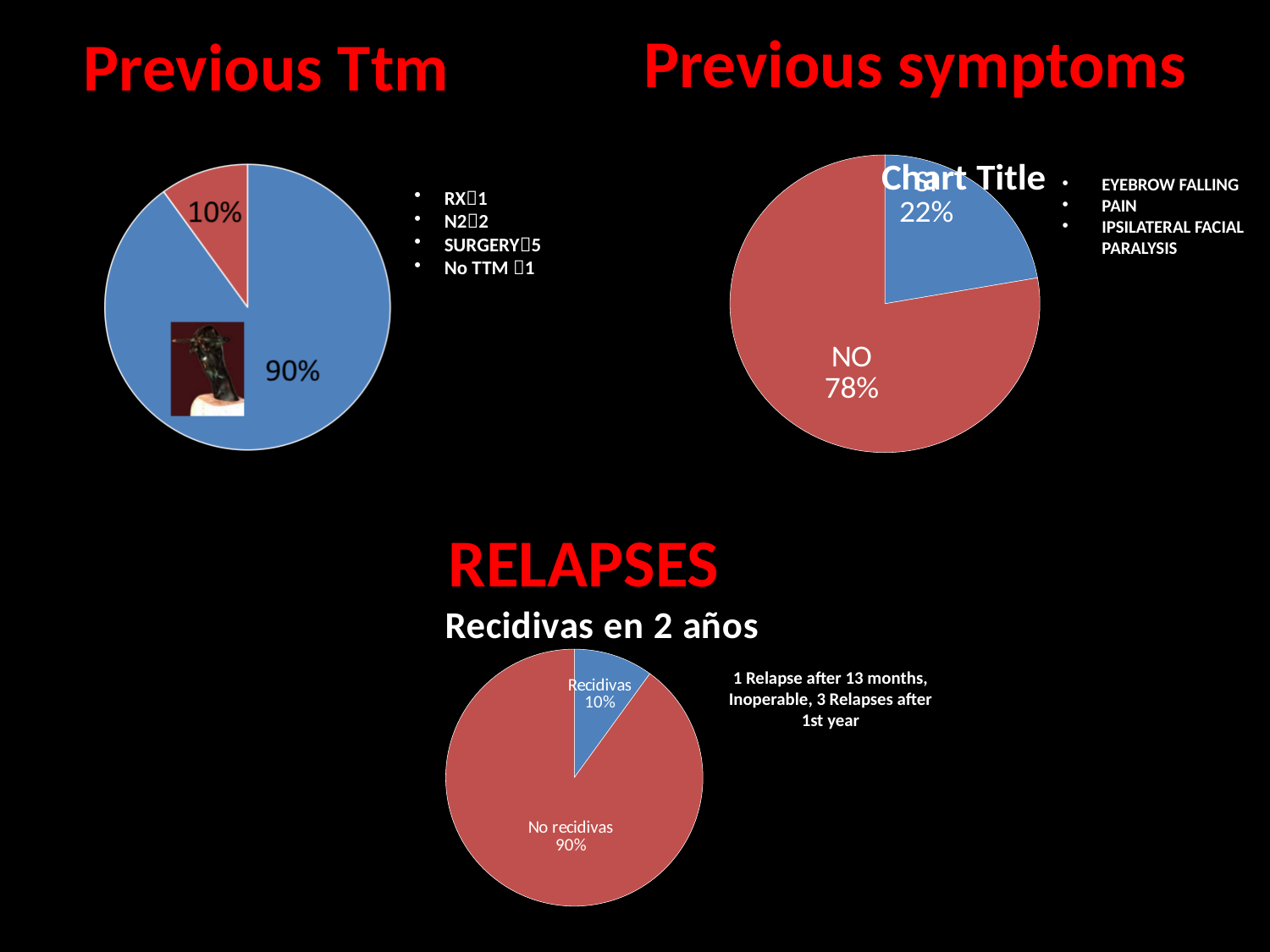
In the 'Previous symptoms' chart on the top right, what is the difference between the two slice percentages? 56% What kind of chart is shown under 'Recidivas en 2 años'? Pie chart In the 'Previous symptoms' chart on the top right, what percentage is shown on the blue slice? 22% In the 'Recidivas en 2 años' chart, what is the difference between the 'No recidivas' and 'Recidivas' shares? 80% How many slices does the 'Recidivas en 2 años' pie chart have? 2 What kind of chart is shown under 'Previous Ttm'? Pie chart In the 'Recidivas en 2 años' chart, which slice is larger, 'Recidivas' or 'No recidivas'? No recidivas In the 'Previous symptoms' chart on the top right, what share of the pie is labelled 'NO'? 78% In the 'Recidivas en 2 años' chart, what share of the pie is 'Recidivas'? 10% In the 'Recidivas en 2 años' chart, what share of the pie is 'No recidivas'? 90% In the 'Previous Ttm' chart on the top left, what percentage is shown on the red slice? 10% In the 'Previous Ttm' chart on the top left, what percentage is shown on the blue slice? 90%